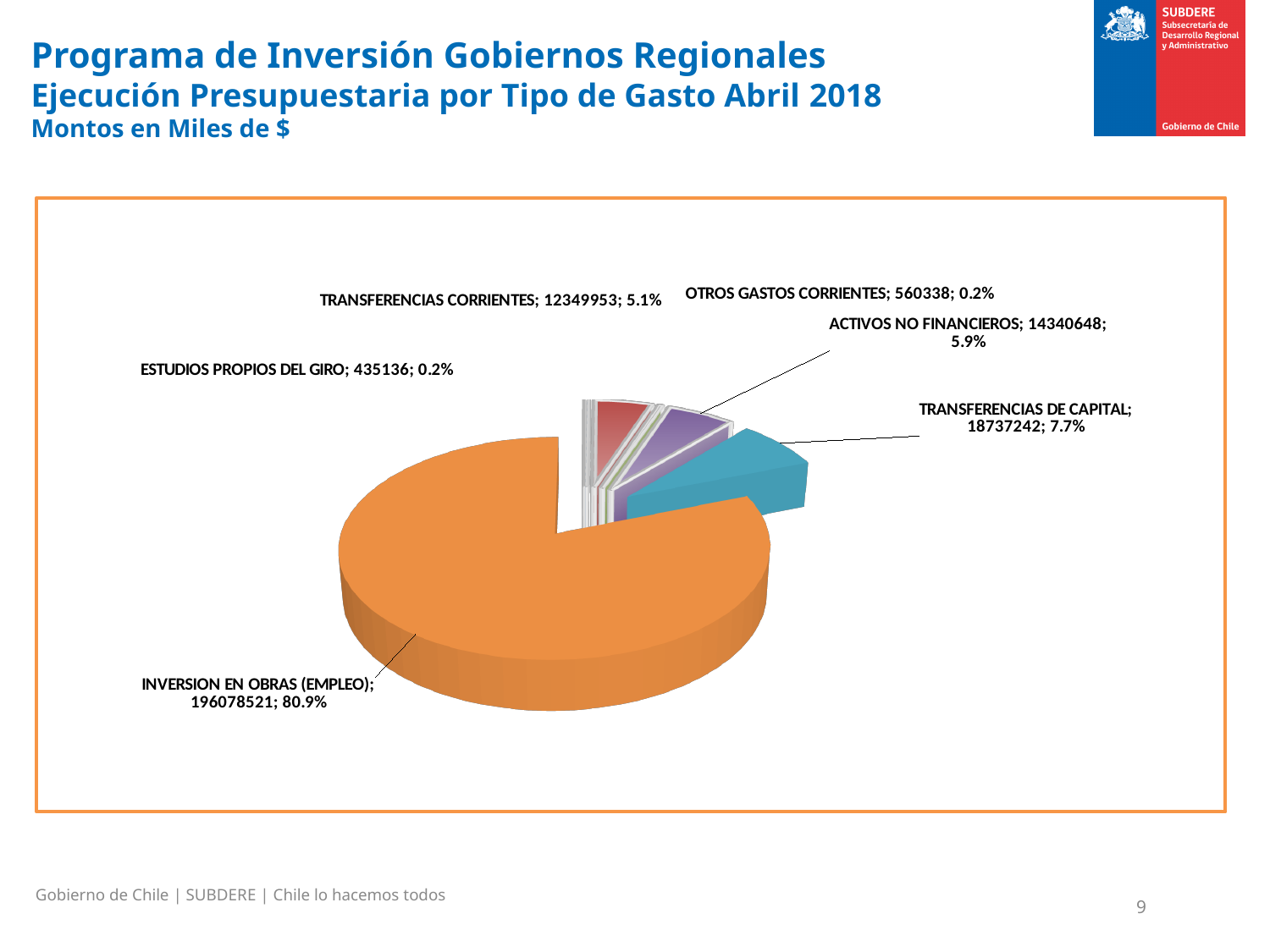
What is the value for TRANSFERENCIAS DE CAPITAL? 18737242 What is the value for OTROS GASTOS CORRIENTES? 560338 Which category has the smallest value in the pie chart? ESTUDIOS PROPIOS DEL GIRO What is the value for INVERSION EN OBRAS (EMPLEO)? 196078521 What type of chart is shown on the slide? Pie chart Which category has the largest slice of the pie? INVERSION EN OBRAS (EMPLEO) Which is larger, the value for ACTIVOS NO FINANCIEROS or the value for TRANSFERENCIAS CORRIENTES? ACTIVOS NO FINANCIEROS What unit are the amounts in the chart expressed in, according to the slide subtitle? Miles de $ How many categories (slices) does the pie chart show? 6 What percentage is shown for ACTIVOS NO FINANCIEROS? 5.9% What share of the pie does INVERSION EN OBRAS (EMPLEO) represent? 80.9% What is the difference between the values for TRANSFERENCIAS DE CAPITAL and ACTIVOS NO FINANCIEROS? 4396594